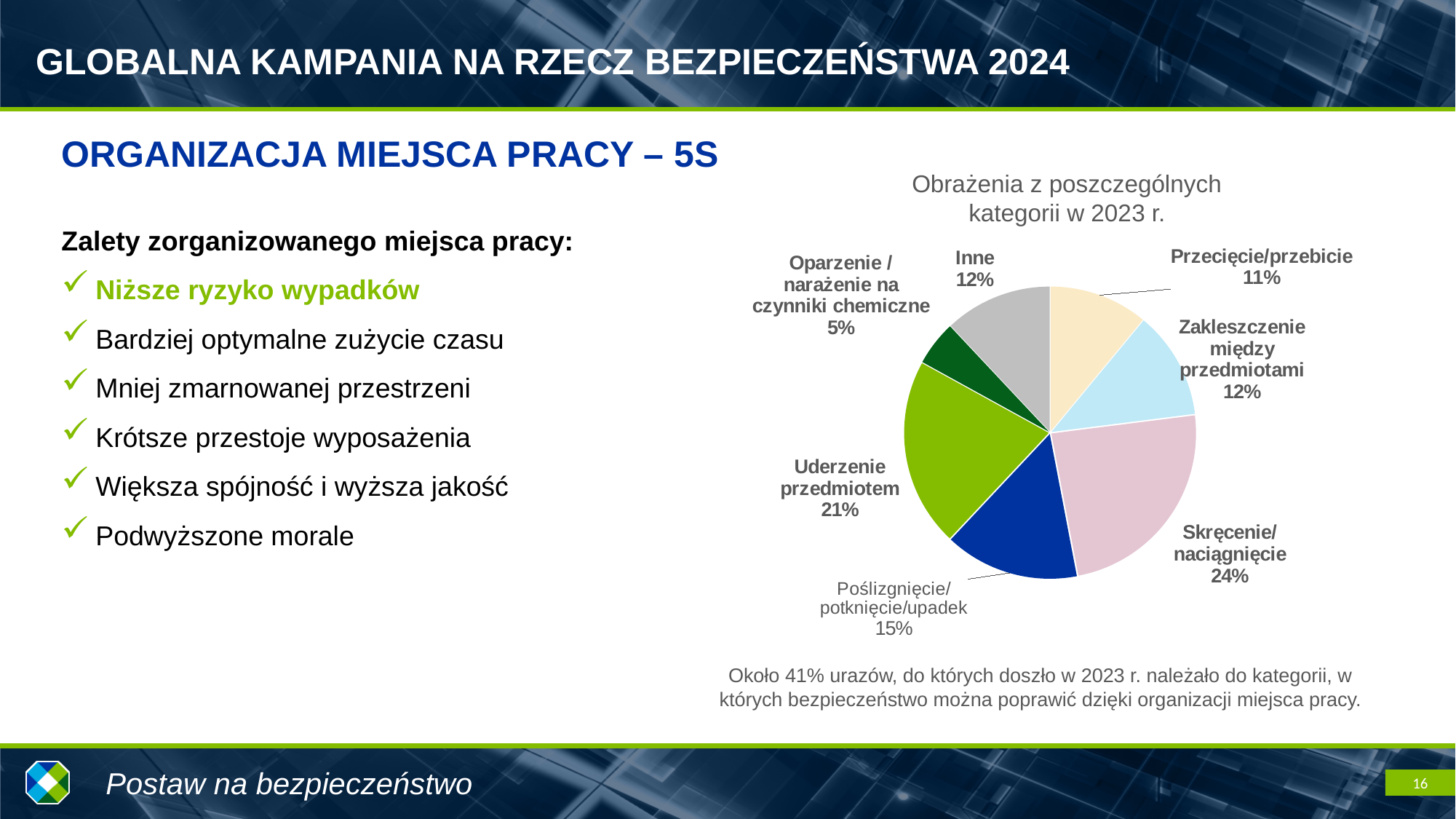
What is the combined share of Inne and Zakleszczenie między przedmiotami? 24% What is the difference in percentage points between Skręcenie/naciągnięcie and Przecięcie/przebicie? 13 What is the title of the chart? Obrażenia z poszczególnych kategorii w 2023 r. What share of injuries is attributed to Uderzenie przedmiotem? 21% Which category has the smallest share of the pie? Oparzenie / narażenie na czynniki chemiczne What share of injuries is attributed to Oparzenie / narażenie na czynniki chemiczne? 5% What share of injuries is attributed to Poślizgnięcie/potknięcie/upadek? 15% How many categories does the pie chart show? 7 What type of chart is shown on the slide? pie chart Which is larger: the share for Uderzenie przedmiotem or the share for Poślizgnięcie/potknięcie/upadek? Uderzenie przedmiotem Which category has the largest share of the pie? Skręcenie/naciągnięcie What share of injuries is attributed to Skręcenie/naciągnięcie? 24%